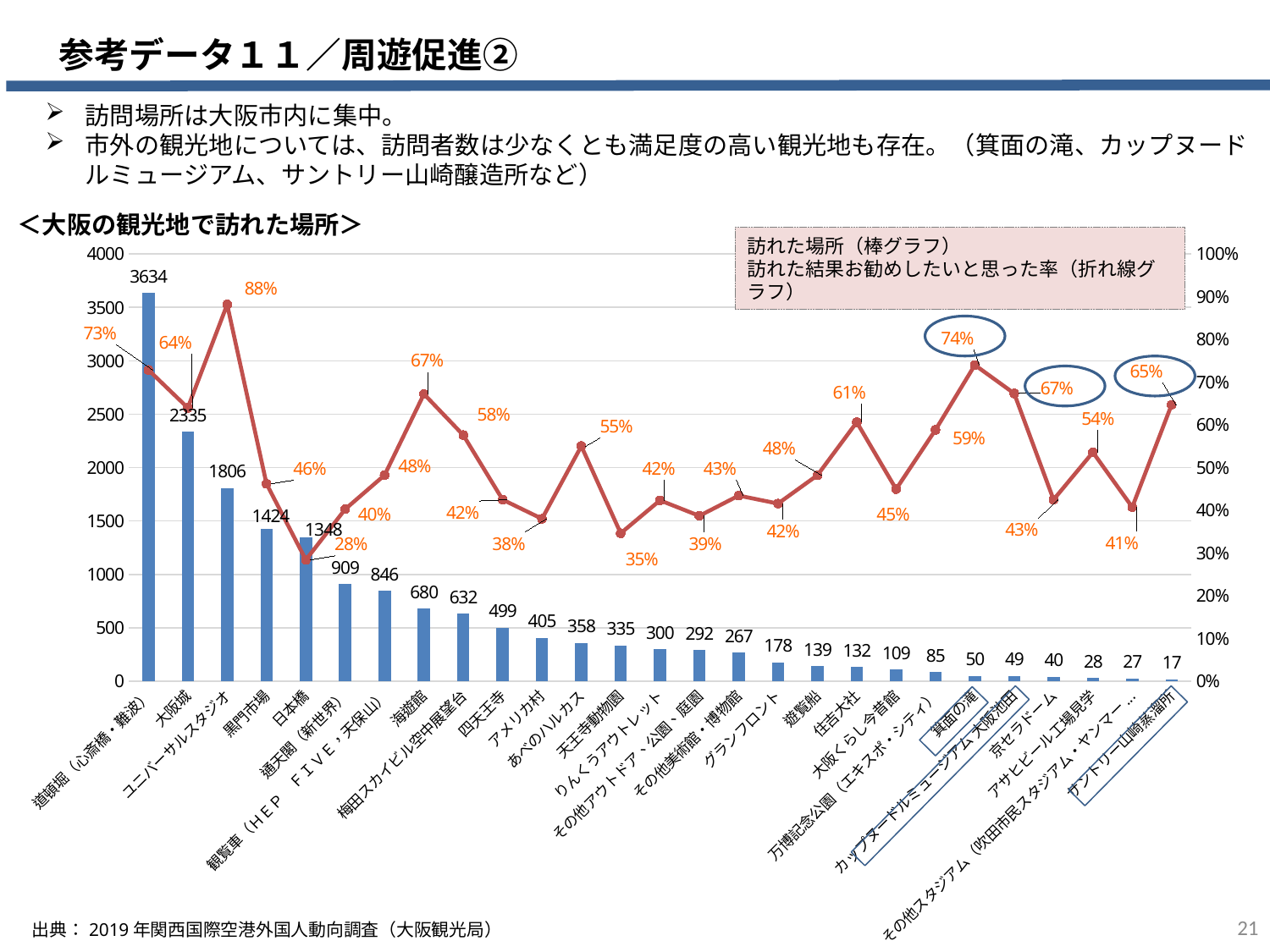
「大阪の観光地で訪れた場所」のグラフで、箕面の滝のお勧めしたいと思った率は何％ですか？ 74% 「大阪の観光地で訪れた場所」のグラフで、訪問者数が最も少ない場所はどこですか？ サントリー山崎蒸溜所 「大阪の観光地で訪れた場所」のグラフには、いくつの観光地（カテゴリ）が示されていますか？ 27 「大阪の観光地で訪れた場所」のグラフで、黒門市場と日本橋では、お勧めしたいと思った率はどちらが高いですか？ 黒門市場 「大阪の観光地で訪れた場所」のグラフで、道頓堀（心斎橋・難波）の訪問者数はいくつですか？ 3634 「大阪の観光地で訪れた場所」のグラフで、大阪城とユニバーサルスタジオの訪問者数の差はいくつですか？ 529 「大阪の観光地で訪れた場所」のグラフで、棒グラフの訪問者数は全体として左から右へ増加していますか、減少していますか？ 減少 「大阪の観光地で訪れた場所」のグラフで、海遊館の訪問者数はいくつですか？ 680 「大阪の観光地で訪れた場所」のグラフで、ユニバーサルスタジオのお勧めしたいと思った率は何％ですか？ 88% 「大阪の観光地で訪れた場所」のグラフで、お勧めしたいと思った率が最も高い場所はどこですか？ ユニバーサルスタジオ 「大阪の観光地で訪れた場所」のグラフで、訪問者数が最も多い場所はどこですか？ 道頓堀（心斎橋・難波） 「大阪の観光地で訪れた場所」のグラフで、折れ線グラフは何を表していますか？ 訪れた結果お勧めしたいと思った率